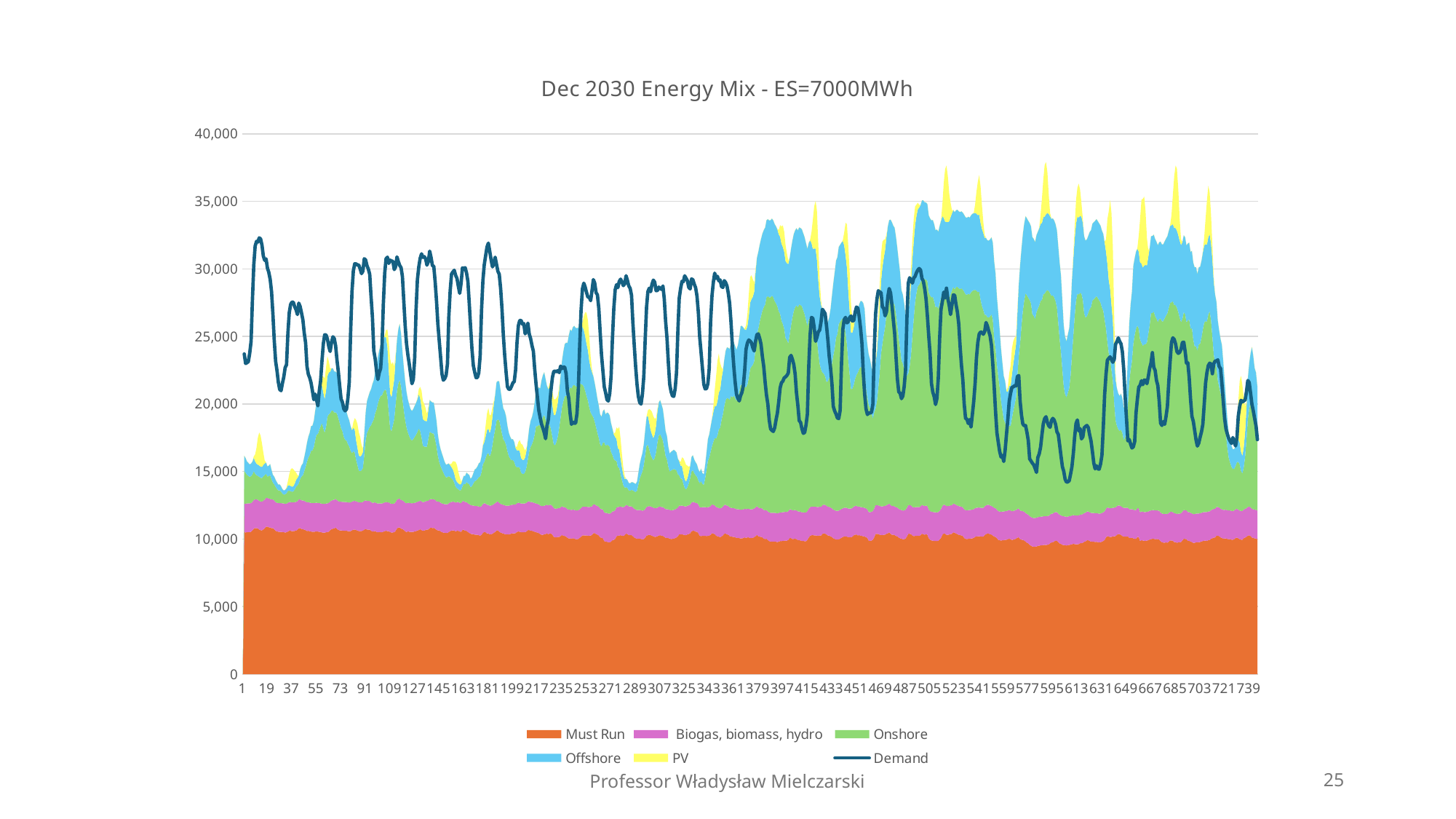
What is the title of the chart? Dec 2030 Energy Mix - ES=7000MWh At hour 1, which is larger: the Demand line or the total stacked generation? Demand Is the total stacked generation at hour 1 greater or less than 20,000? less Which series is drawn as a line rather than a filled area? Demand What kind of chart is this? stacked area chart Is the highest value of the Demand line greater or less than 30,000? greater Is the Must Run value at hour 1 greater or less than 15,000? less Does the Demand line generally rise or fall from the start of the month to the end? fall How many series does the legend list? 6 Which is larger at hour 1: the Must Run area or the Biogas, biomass, hydro area? Must Run